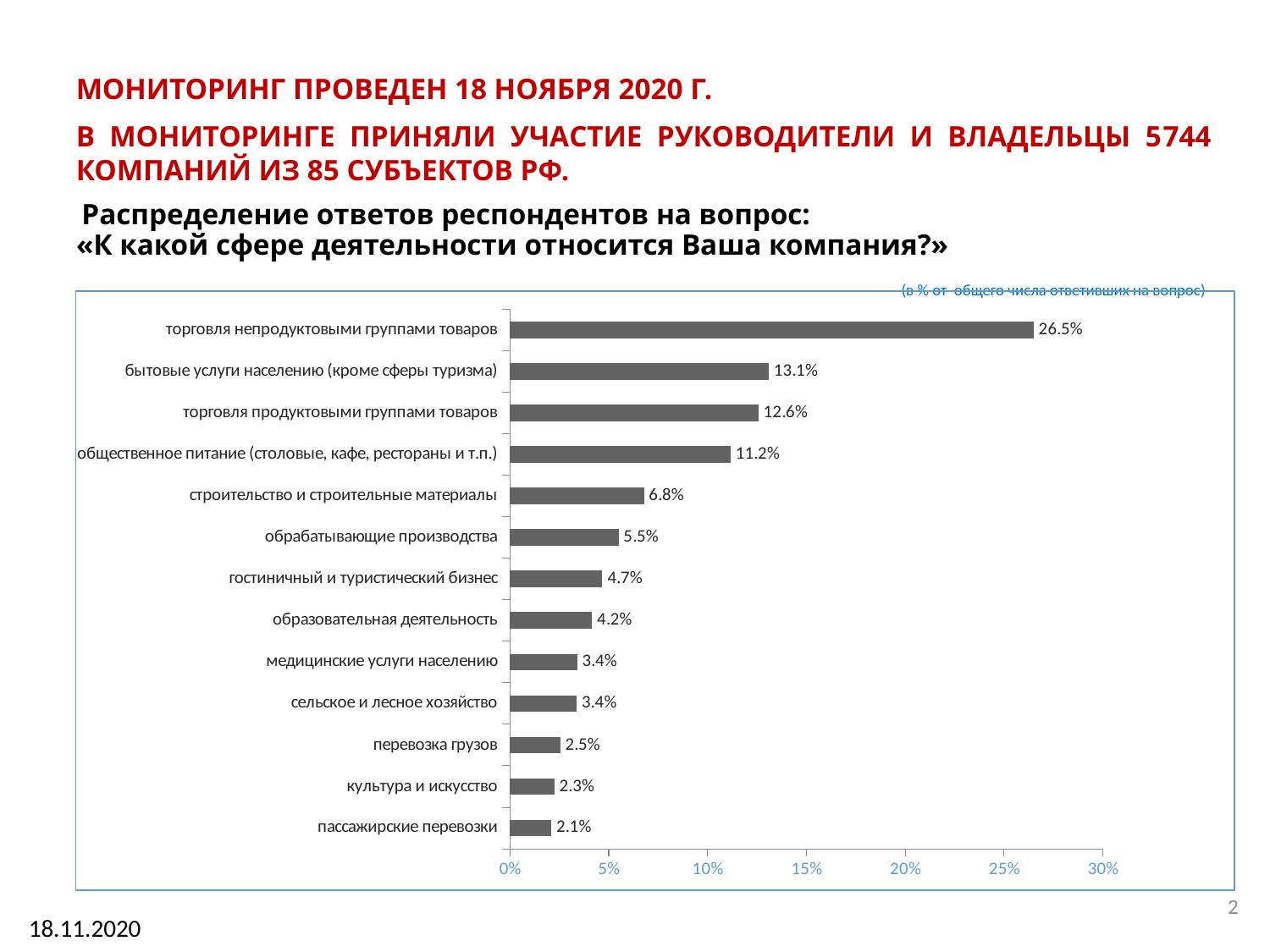
What is the value for «торговля непродуктовыми группами товаров»? 26.5% How many categories are shown in the chart? 13 What is the maximum value shown on the horizontal axis? 30% Is the value for «образовательная деятельность» greater or less than 5%? less Which category has the lowest value? пассажирские перевозки Which category has the highest value? торговля непродуктовыми группами товаров What is the value for «общественное питание (столовые, кафе, рестораны и т.п.)»? 11.2% What kind of chart is shown on the slide? bar chart What is the difference between «торговля непродуктовыми группами товаров» and «пассажирские перевозки»? 24.4% What is the value for «гостиничный и туристический бизнес»? 4.7% Which is larger: «строительство и строительные материалы» or «обрабатывающие производства»? строительство и строительные материалы What is the difference between «бытовые услуги населению (кроме сферы туризма)» and «торговля продуктовыми группами товаров»? 0.5%